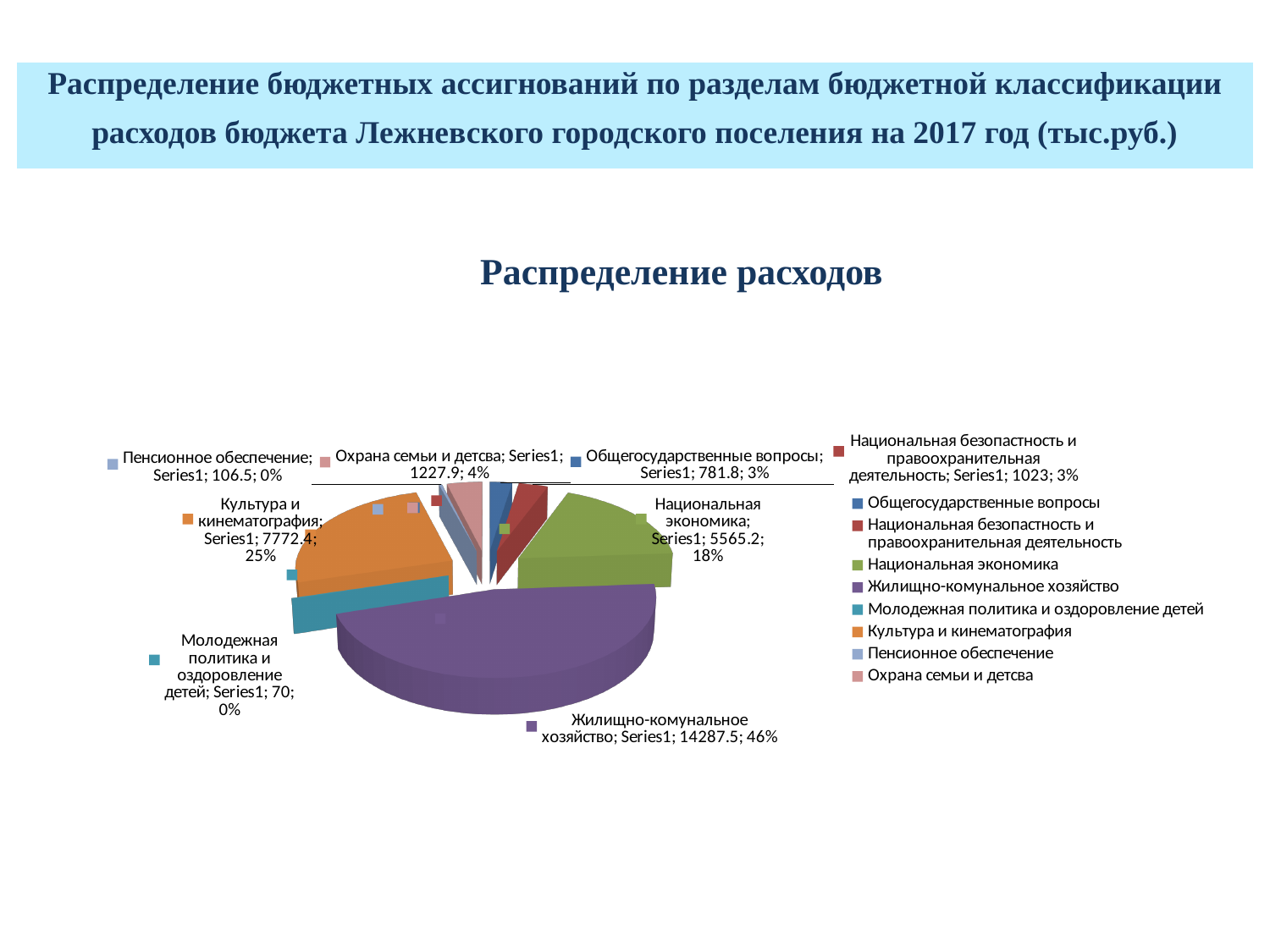
What kind of chart is shown on the slide? pie chart What is the value for Национальная экономика? 5565.2 What share of the pie does Национальная экономика take? 18% What share of the pie does Жилищно-коммунальное хозяйство take? 46% Which category has the largest slice? Жилищно-коммунальное хозяйство What is the value for Охрана семьи и детсва? 1227.9 What is the value for Жилищно-коммунальное хозяйство? 14287.5 Which category has the smallest value? Молодежная политика и оздоровление детей What is the value for Культура и кинематография? 7772.4 What is the difference between the values for Жилищно-коммунальное хозяйство and Культура и кинематография? 6515.1 How many categories does the pie chart have? 8 Which is larger, the value for Национальная безопасность и правоохранительная деятельность or the value for Общегосударственные вопросы? Национальная безопасность и правоохранительная деятельность